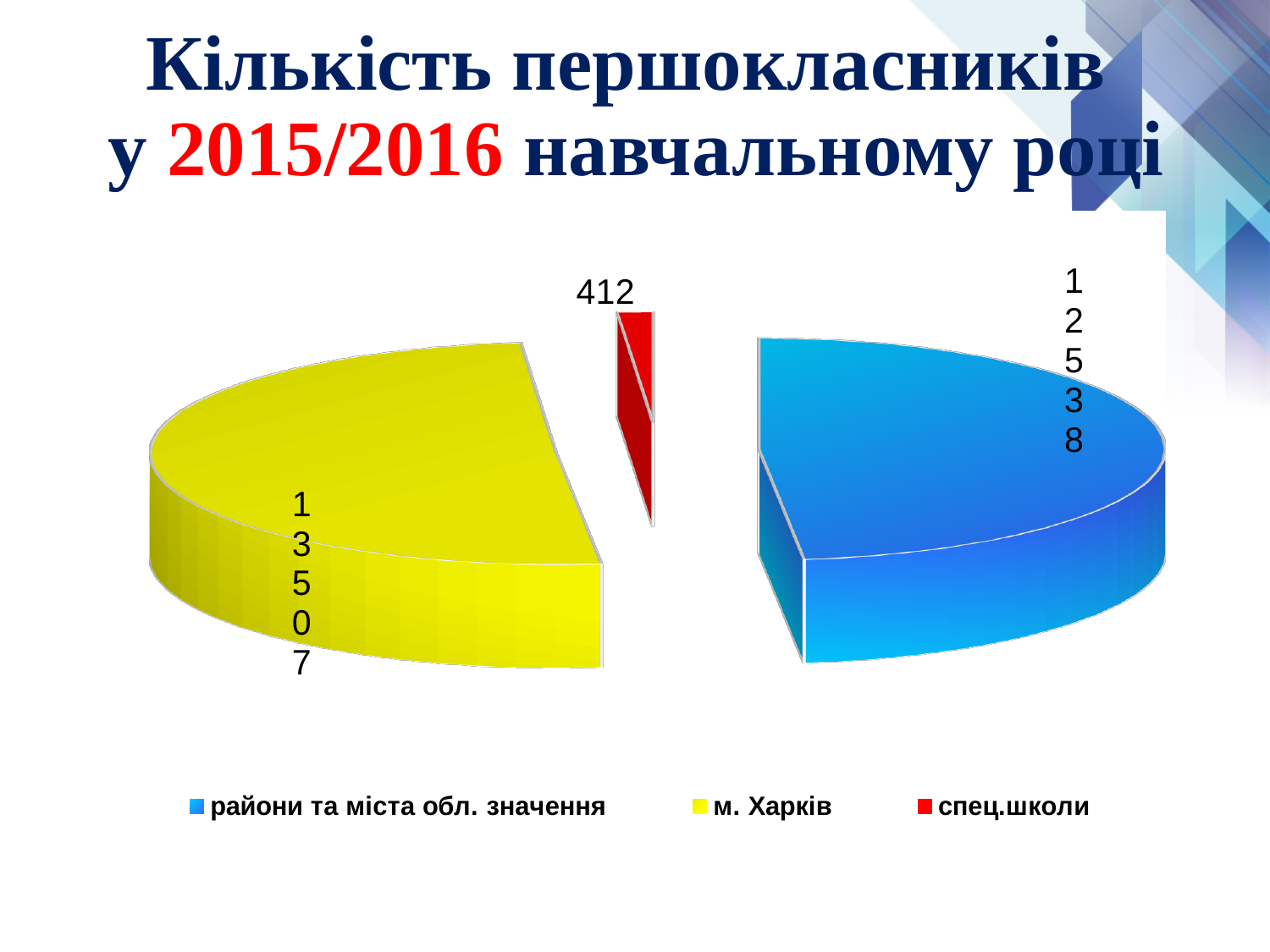
What colour is the slice for спец.школи? red How many categories does the pie chart have? 3 Which category has the smallest slice? спец.школи What is the difference between the values for райони та міста обл. значення and спец.школи? 12126 What type of chart is shown on the slide? pie chart What is the difference between the values for м. Харків and райони та міста обл. значення? 969 What is the value for м. Харків? 13507 Which is larger, the value for м. Харків or the value for спец.школи? м. Харків What is the value for райони та міста обл. значення? 12538 What is the value for спец.школи? 412 What is the title of the slide? Кількість першокласників у 2015/2016 навчальному році Which category has the largest slice? м. Харків